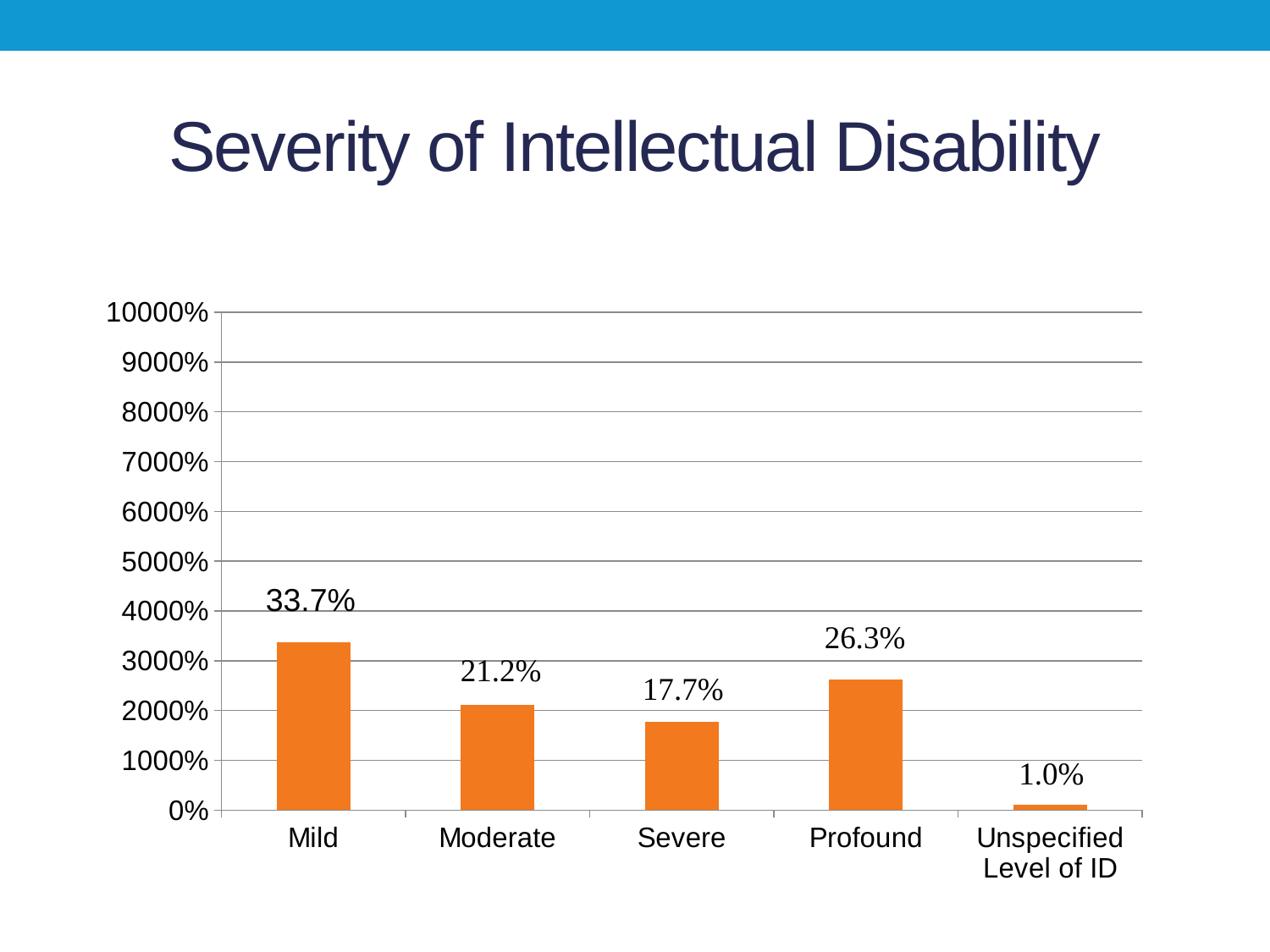
Which category has the lowest value? Unspecified Level of ID What kind of chart is shown on the slide? Bar chart What is the value for Profound? 26.3% What is the value for Mild? 33.7% Which category has the highest value? Mild What is the value for Severe? 17.7% What is the value for Moderate? 21.2% What is the difference between the values for Moderate and Severe? 3.5% What is the difference between the values for Mild and Profound? 7.4% Which is larger, the value for Profound or the value for Moderate? Profound What is the value for Unspecified Level of ID? 1.0% How many categories are shown on the x axis? 5